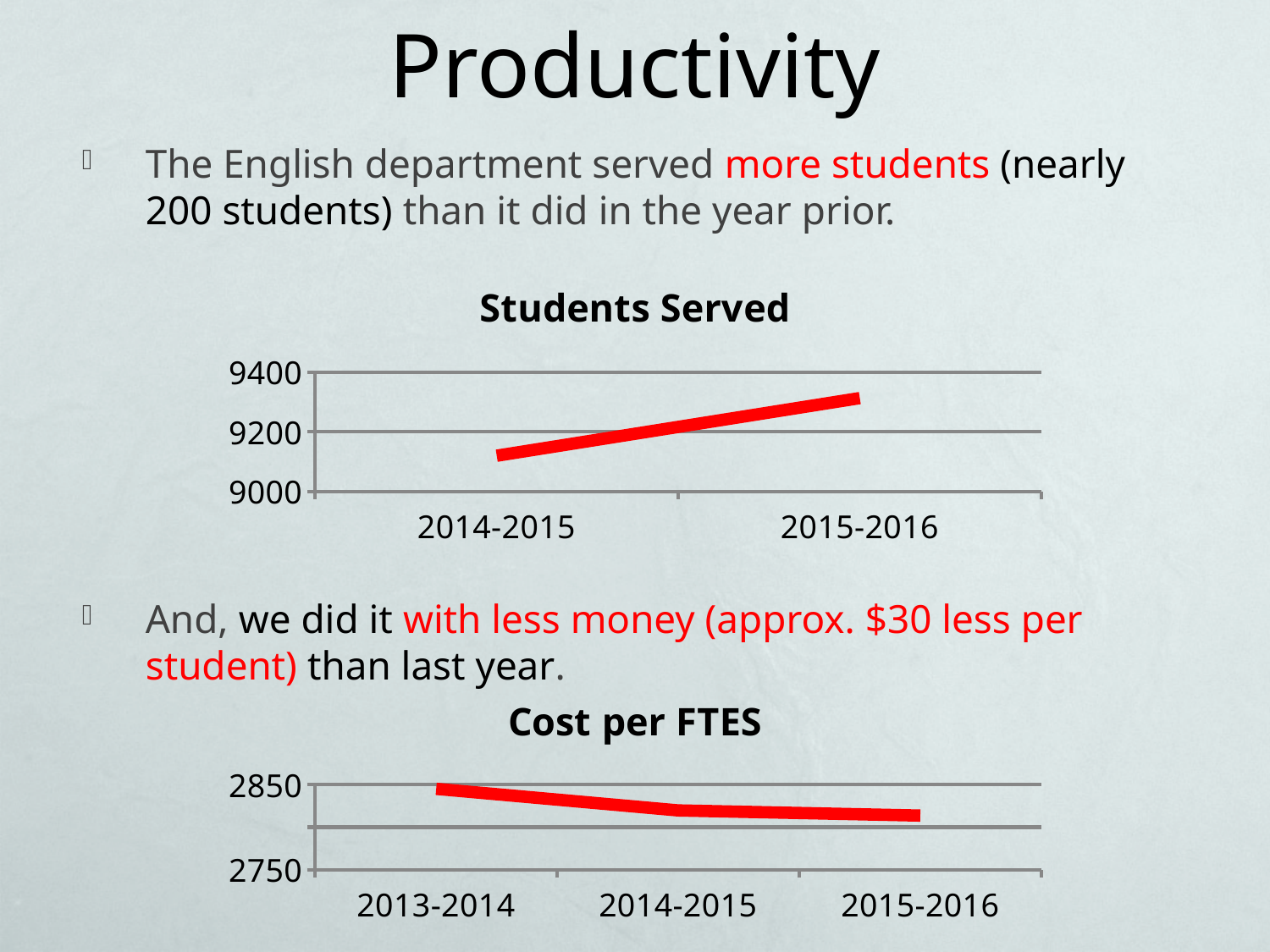
In the "Students Served" chart, do the values rise or fall from 2014-2015 to 2015-2016? rise In the "Cost per FTES" chart, which year has the highest value? 2013-2014 In the "Students Served" chart, how many years are plotted on the x axis? 2 In the "Cost per FTES" chart, how many years are plotted on the x axis? 3 In the "Students Served" chart, is the value for 2015-2016 greater or less than 9200? greater In the "Cost per FTES" chart, do the values rise or fall from 2013-2014 to 2015-2016? fall What kind of chart is the "Cost per FTES" chart? line chart In the "Cost per FTES" chart, which is larger, the value for 2013-2014 or the value for 2015-2016? 2013-2014 In the "Students Served" chart, which year has the higher value? 2015-2016 In the "Cost per FTES" chart, is the value for 2015-2016 greater or less than 2750? greater What kind of chart is the "Students Served" chart? line chart In the "Students Served" chart, is the value for 2014-2015 greater or less than 9200? less